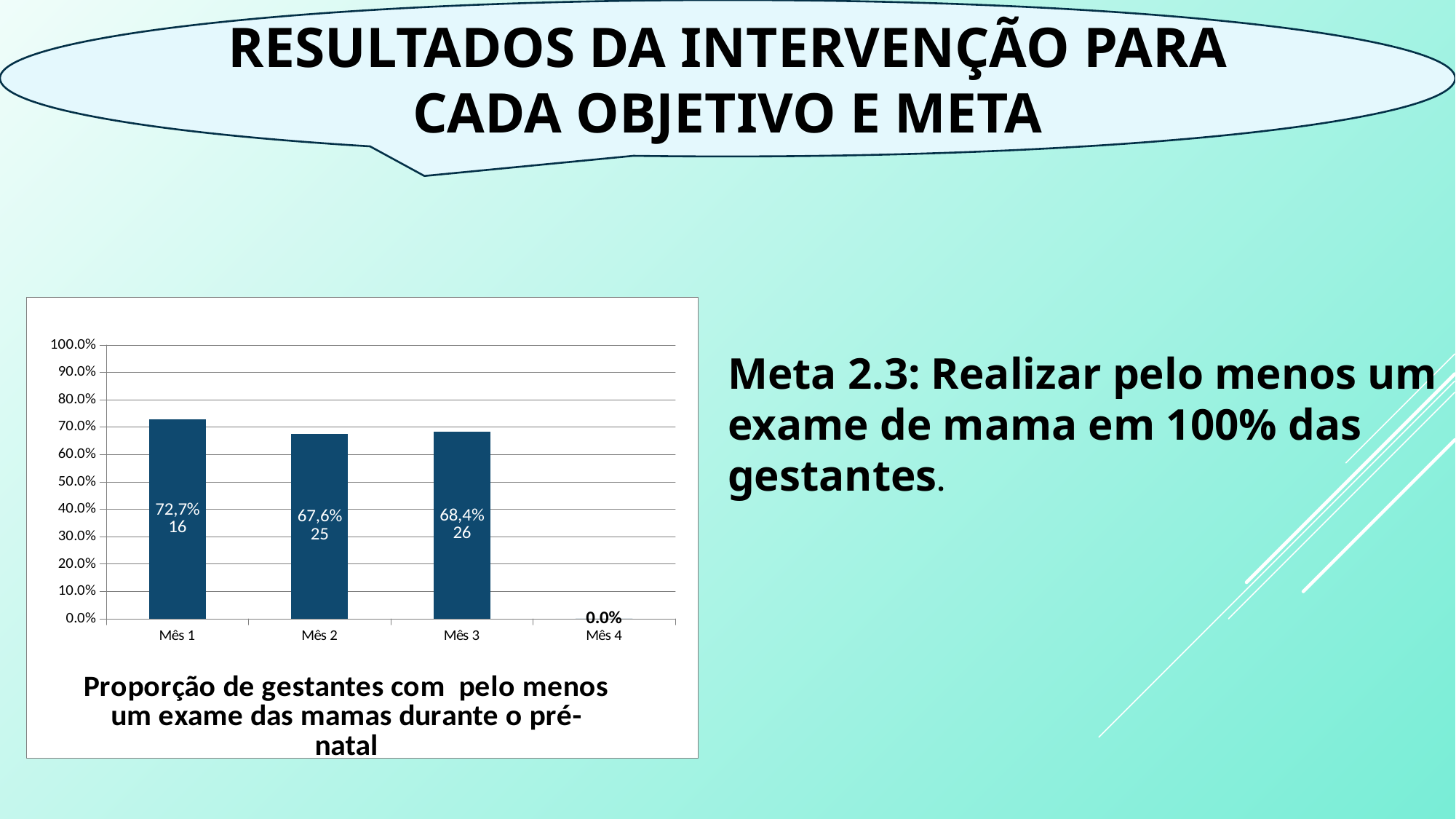
Which month has the highest percentage? Mês 1 What type of chart is shown on the slide? Bar chart Is the value for Mês 1 greater or less than 70%? greater What is the percentage value shown for Mês 3? 68,4% How many months (categories) are shown on the x axis? 4 Which month has the lowest percentage? Mês 4 Which is larger, the percentage for Mês 2 or for Mês 3? Mês 3 What is the value shown for Mês 4? 0.0% What is the percentage value shown for Mês 2? 67,6% What count is printed inside the bar for Mês 3? 26 What is the percentage value shown for Mês 1? 72,7% What is the title of the chart? Proporção de gestantes com pelo menos um exame das mamas durante o pré-natal